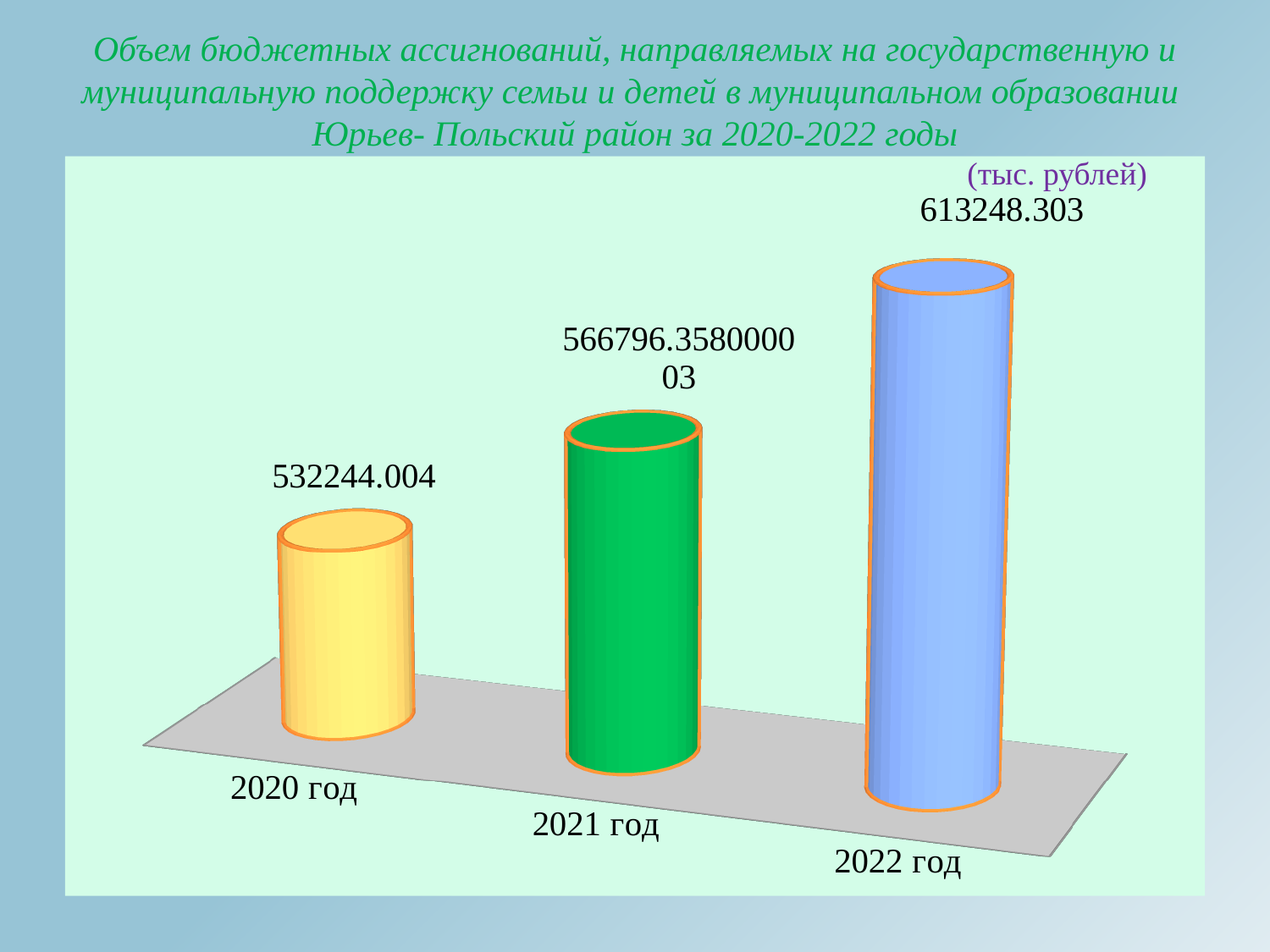
Do the values rise or fall from 2020 год to 2022 год? Rise Which year has the lowest value? 2020 год In what units are the values on the chart given? тыс. рублей What is the value for 2022 год? 613248.303 How many years are shown on the chart? 3 What is the value shown for 2021 год? 566796.358000003 Which year has the highest value? 2022 год What is the difference between the values for 2022 год and 2020 год? 81004.299 What colour is the bar for 2021 год? Green Which is larger, the value for 2021 год or the value for 2020 год? 2021 год What kind of chart is shown on the slide? Bar chart What is the value for 2020 год? 532244.004